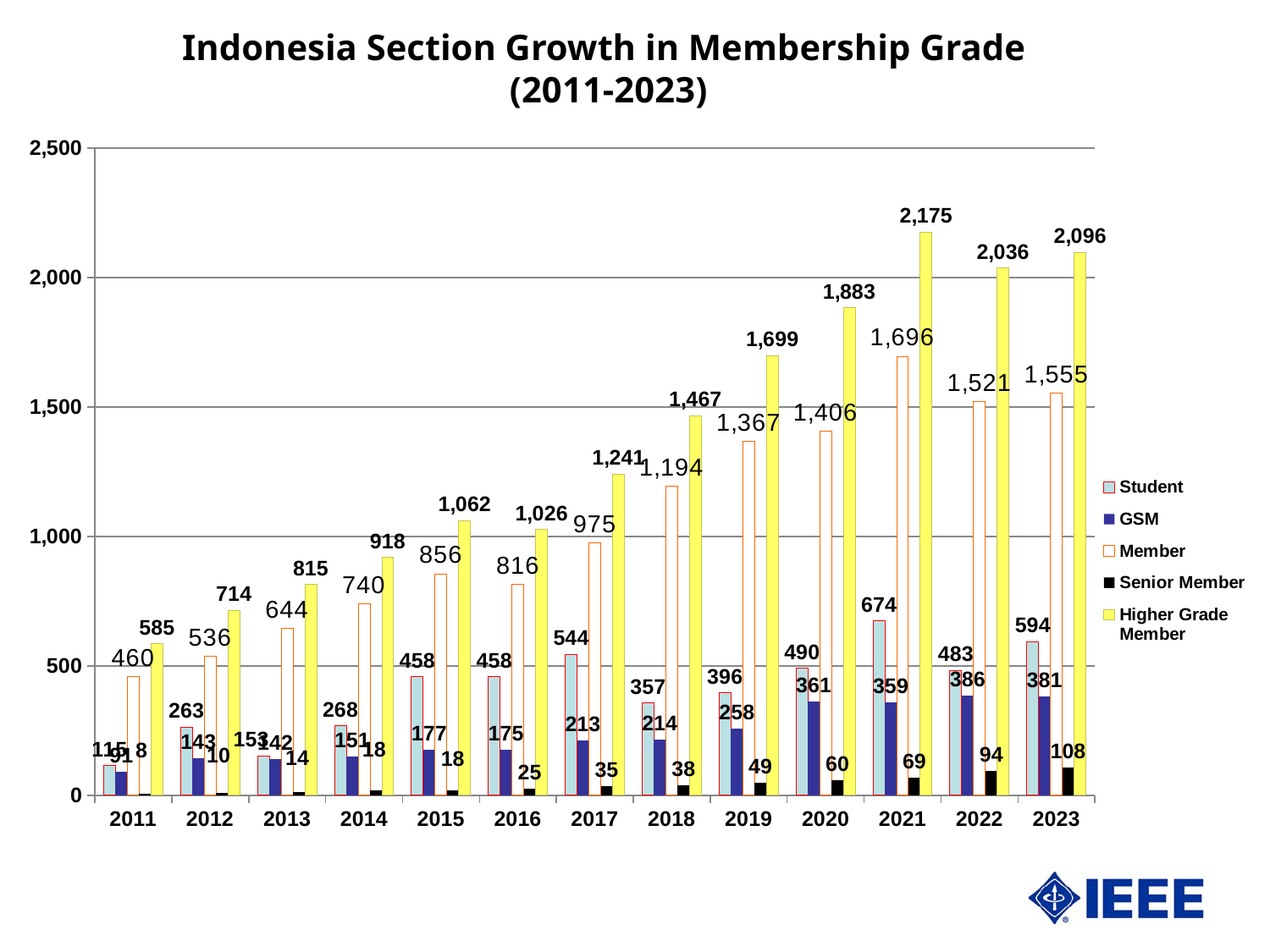
In which year is the Higher Grade Member value highest? 2021 What is the difference between the Higher Grade Member values for 2023 and 2022? 60 Is the value for Member in 2021 greater or less than 1,500? greater What is the value for Senior Member in 2023? 108 How many years are shown on the x axis? 13 Which is larger, the Member value for 2017 or for 2018? 2018 How many series does the legend list? 5 What is the value for Higher Grade Member in 2021? 2,175 What kind of chart is shown on the slide? bar chart What is the value for Member in 2019? 1,367 In which year is the Student value highest? 2021 What is the value for GSM in 2022? 386